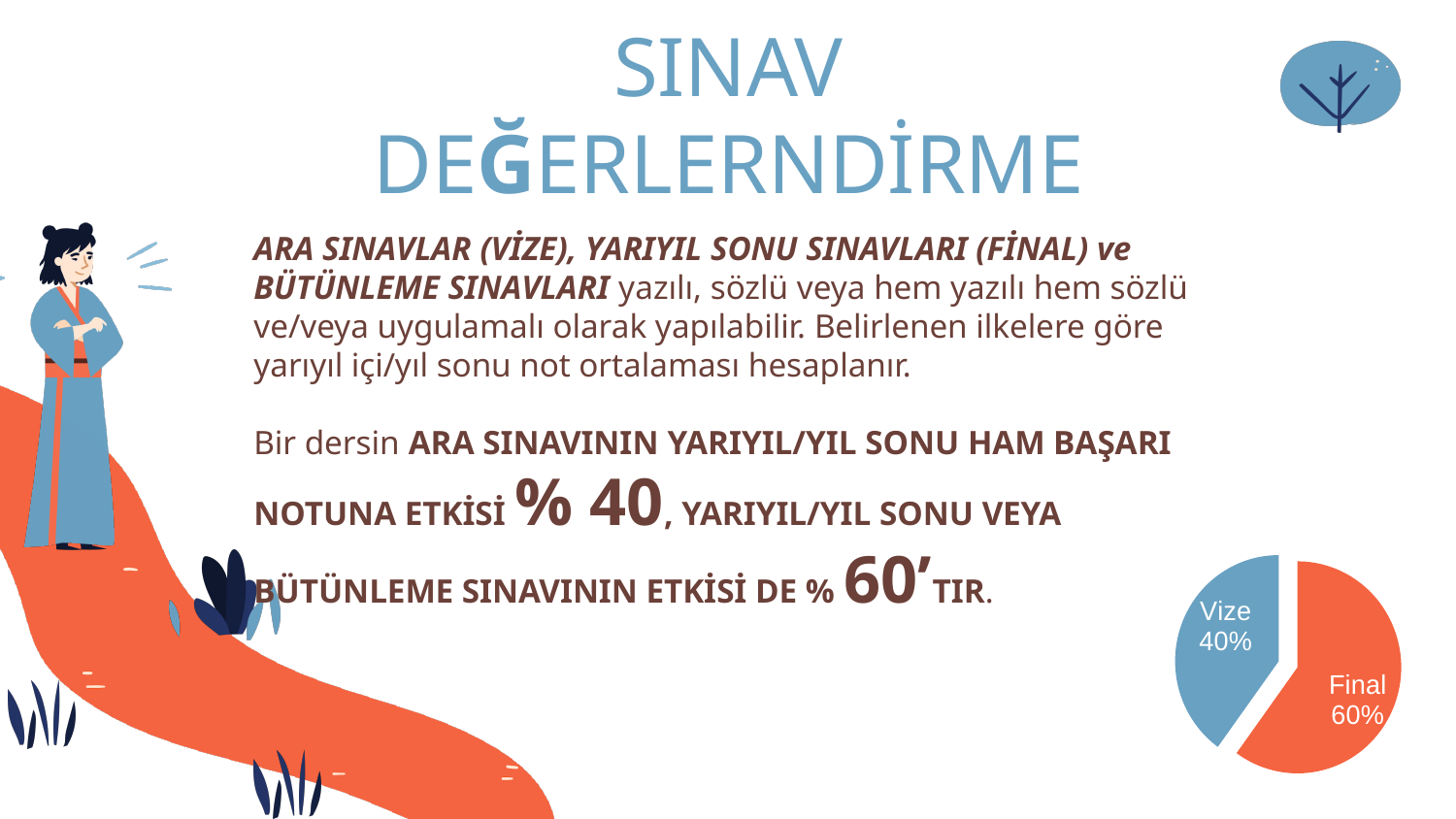
What is the difference between the Final and Vize values in the pie chart? 20% What colour is the Final slice in the pie chart? orange How many slices does the pie chart have? 2 Which slice of the pie chart is the largest? Final What colour is the Vize slice in the pie chart? blue Which is larger in the pie chart, Vize or Final? Final What kind of chart is shown on the slide? pie chart What share of the pie does the Final slice represent? 60% What is the value for Vize in the pie chart? 40% What is the value for Final in the pie chart? 60% What share of the pie does the Vize slice represent? 40% Which slice of the pie chart is the smallest? Vize